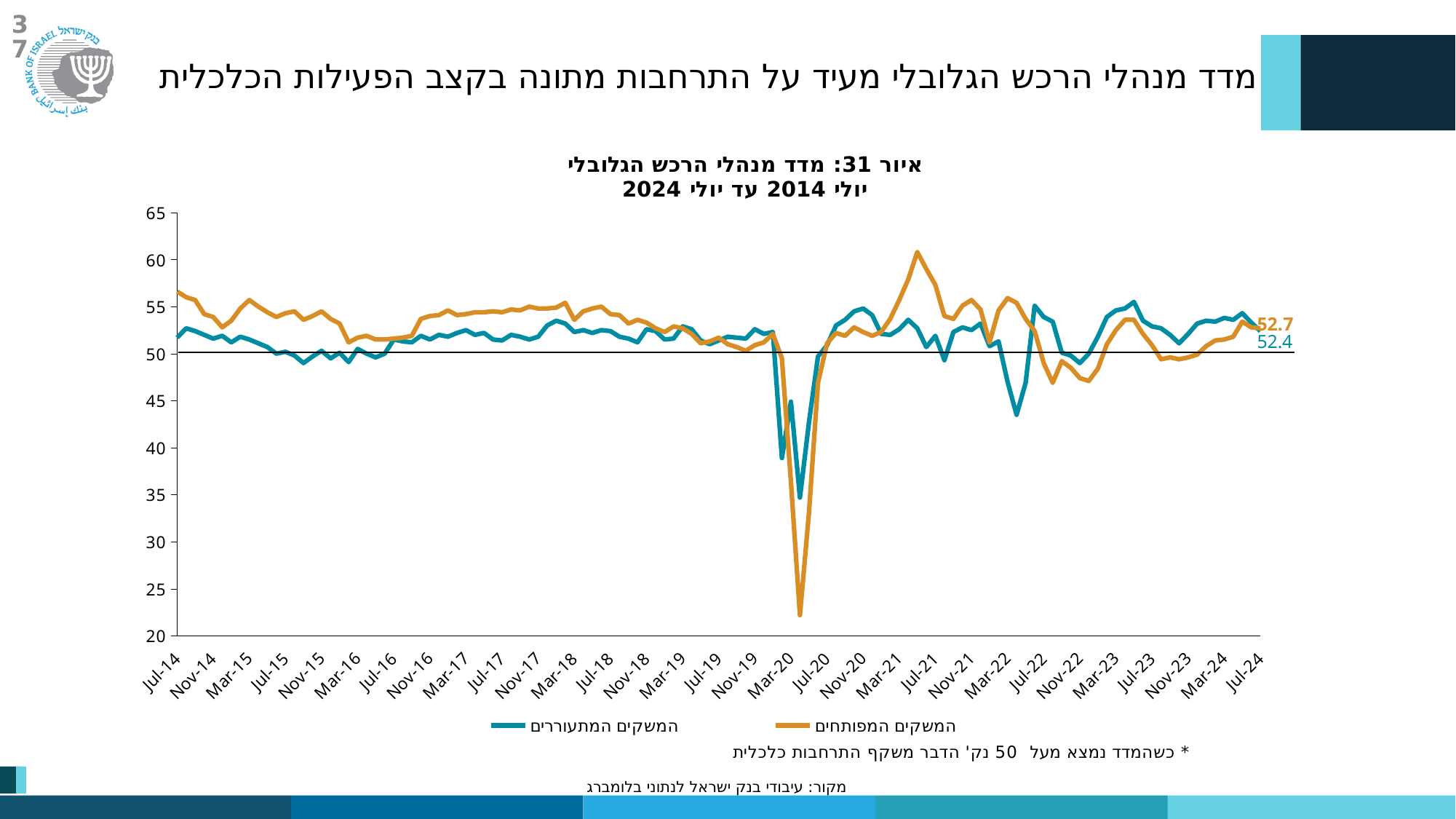
What is the latest (Jul-24) value labelled for the developed economies (המשקים המפותחים) series? 52.7 What period does the chart title say the data covers? יולי 2014 עד יולי 2024 Which series has the higher labelled value at Jul-24, developed economies (המשקים המפותחים) or emerging economies (המשקים המתעוררים)? המשקים המפותחים Is the peak of the developed economies (orange) series around mid-2021 greater or less than 60? greater What is the figure number given in the chart title? 31 What type of chart is shown on the slide? line chart How many series does the legend list? 2 Is the lowest point of the emerging economies (teal) series, around Mar-20, greater or less than 40? less Is the lowest point of the developed economies (orange) series, around Mar-20, greater or less than 25? less What is the latest (Jul-24) value labelled for the emerging economies (המשקים המתעוררים) series? 52.4 What is the difference between the labelled Jul-24 values of the developed economies series and the emerging economies series? 0.3 Which series reaches the lowest value on the chart, developed economies (orange) or emerging economies (teal)? המשקים המפותחים